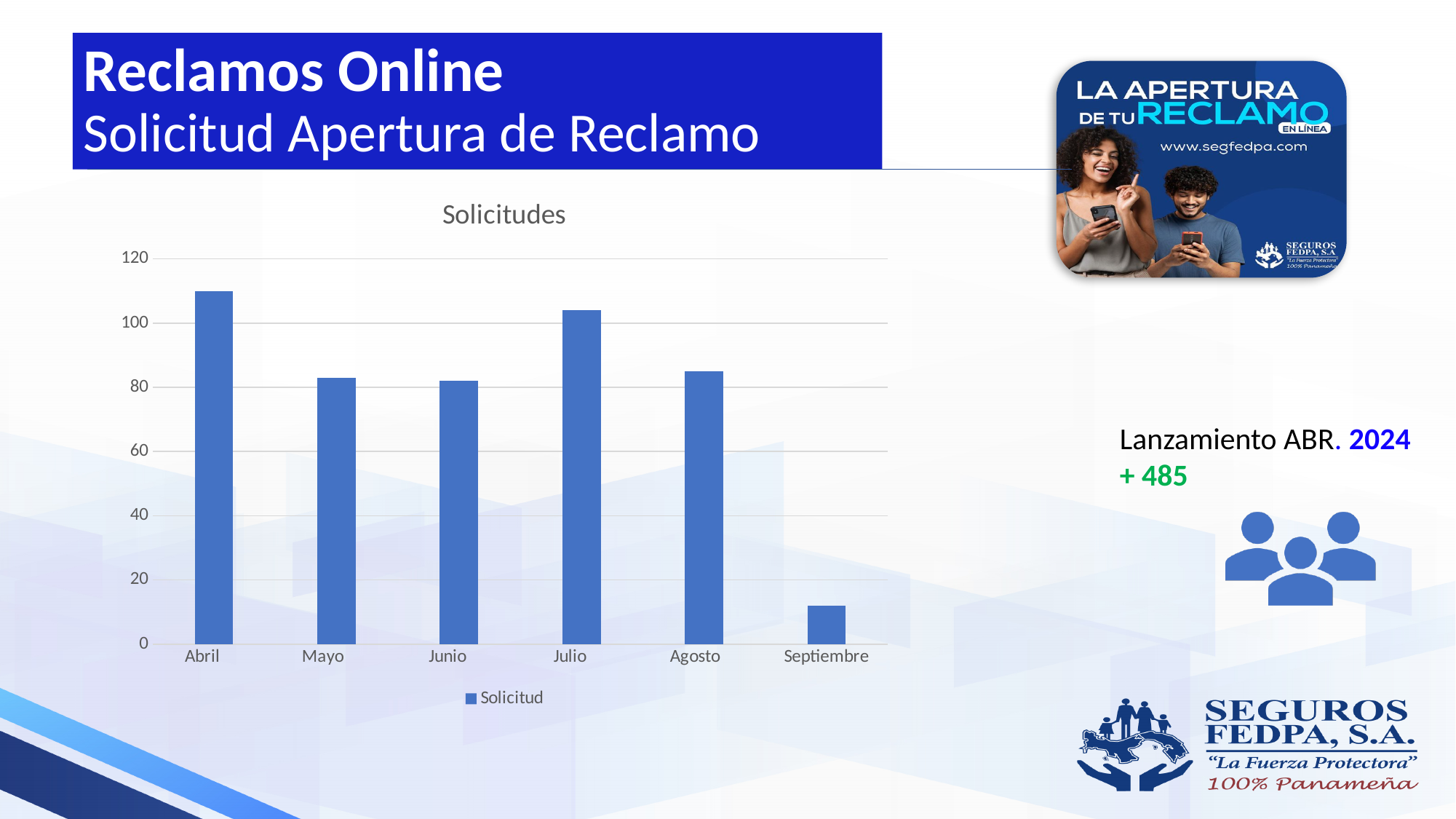
Is the value for Abril greater or less than 100? greater What is the title of the chart? Solicitudes How many series does the chart legend list? 1 What series name does the chart legend show? Solicitud Which month has the highest value in the chart? Abril How many months are shown on the x axis of the chart? 6 Is the value for Mayo greater or less than 100? less Which is larger, the value for Julio or the value for Agosto? Julio Which month has the lowest value in the chart? Septiembre Is the value for Septiembre greater or less than 20? less What type of chart is shown on the slide? bar chart From Julio to Septiembre, do the values rise or fall? fall